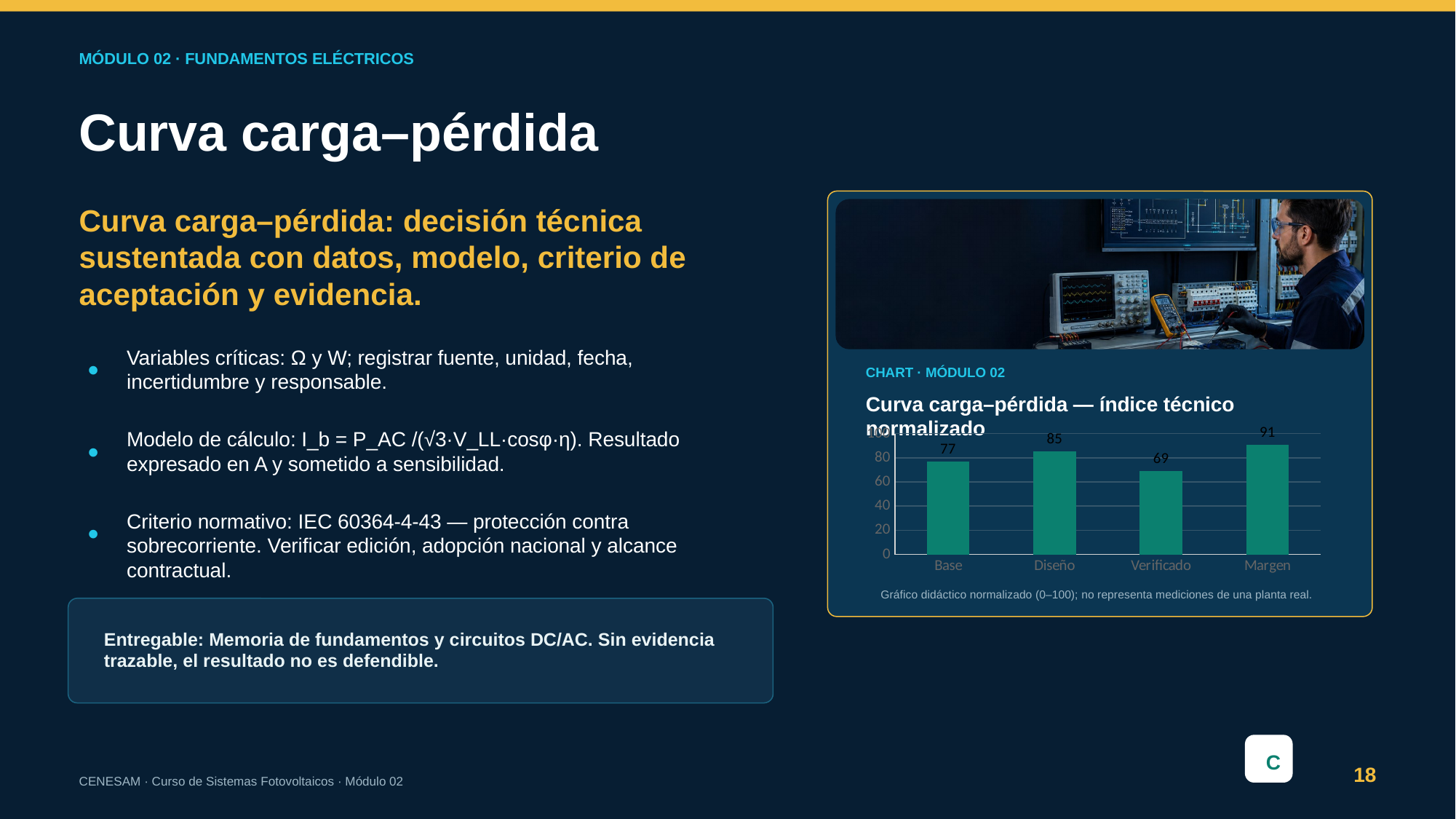
What kind of chart is shown on the slide? Bar chart What is the value for Margen? 91 What is the value for Base? 77 What is the value for Diseño? 85 What is the value for Verificado? 69 How many categories are shown on the x axis? 4 What is the difference between the values for Margen and Verificado? 22 What is the difference between the values for Diseño and Base? 8 Which category has the lowest value? Verificado Which category has the highest value? Margen Which is larger, the value for Base or the value for Diseño? Diseño Is the value for Verificado greater or less than 80? less